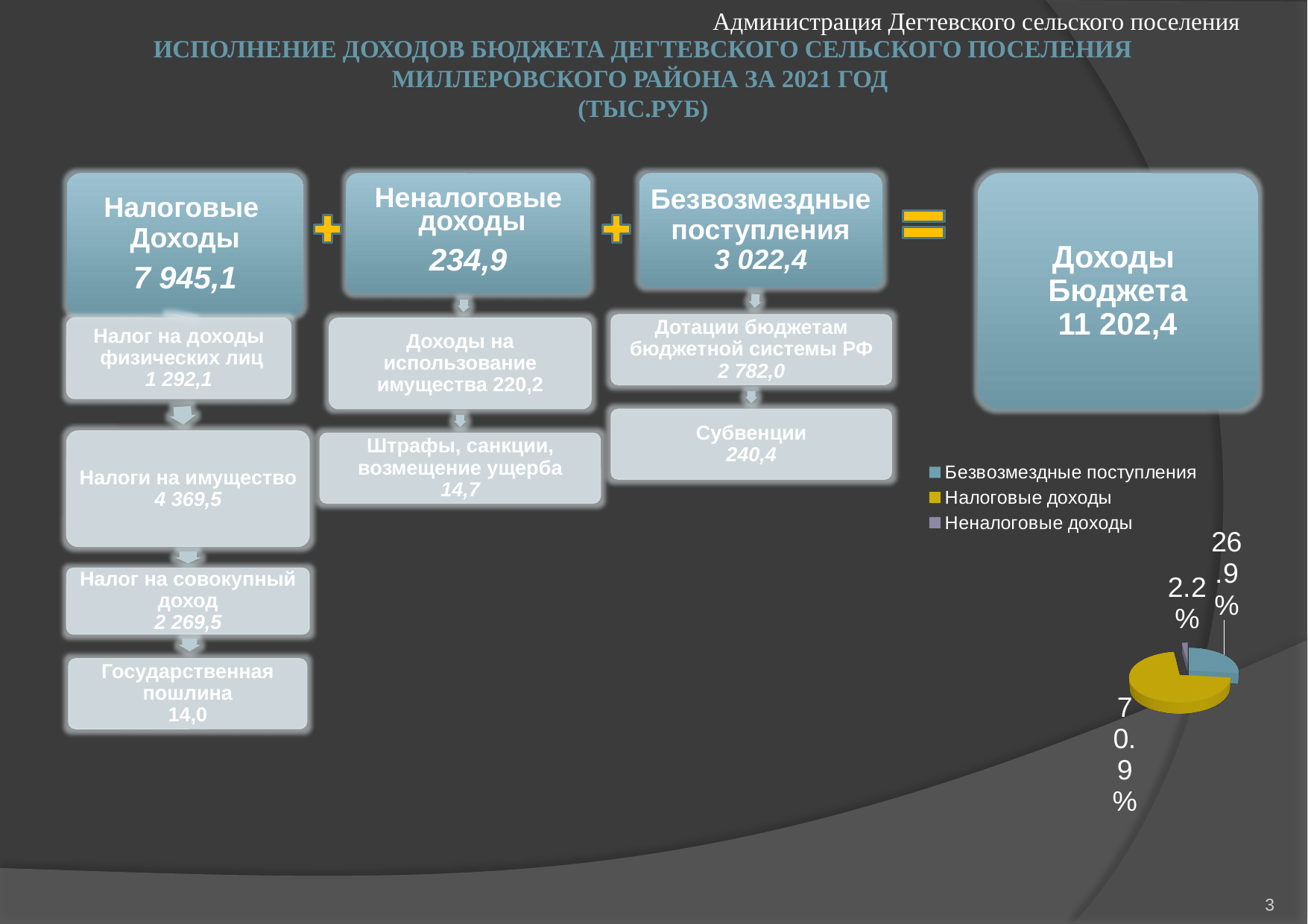
What kind of chart is shown on the slide? pie chart Which category has the largest slice in the pie chart? Налоговые доходы In the pie chart, which is larger: Безвозмездные поступления or Неналоговые доходы? Безвозмездные поступления What share of the pie chart is Налоговые доходы? 70.9% What share of the pie chart is Неналоговые доходы? 2.2% How many slices does the pie chart have? 3 Which legend entry is listed first in the pie chart legend? Безвозмездные поступления What is the difference in percentage points between the Налоговые доходы slice and the Безвозмездные поступления slice? 44.0 How many entries does the pie chart legend list? 3 What share of the pie chart is Безвозмездные поступления? 26.9% Which category has the smallest slice in the pie chart? Неналоговые доходы Which colour represents Налоговые доходы in the pie chart? yellow